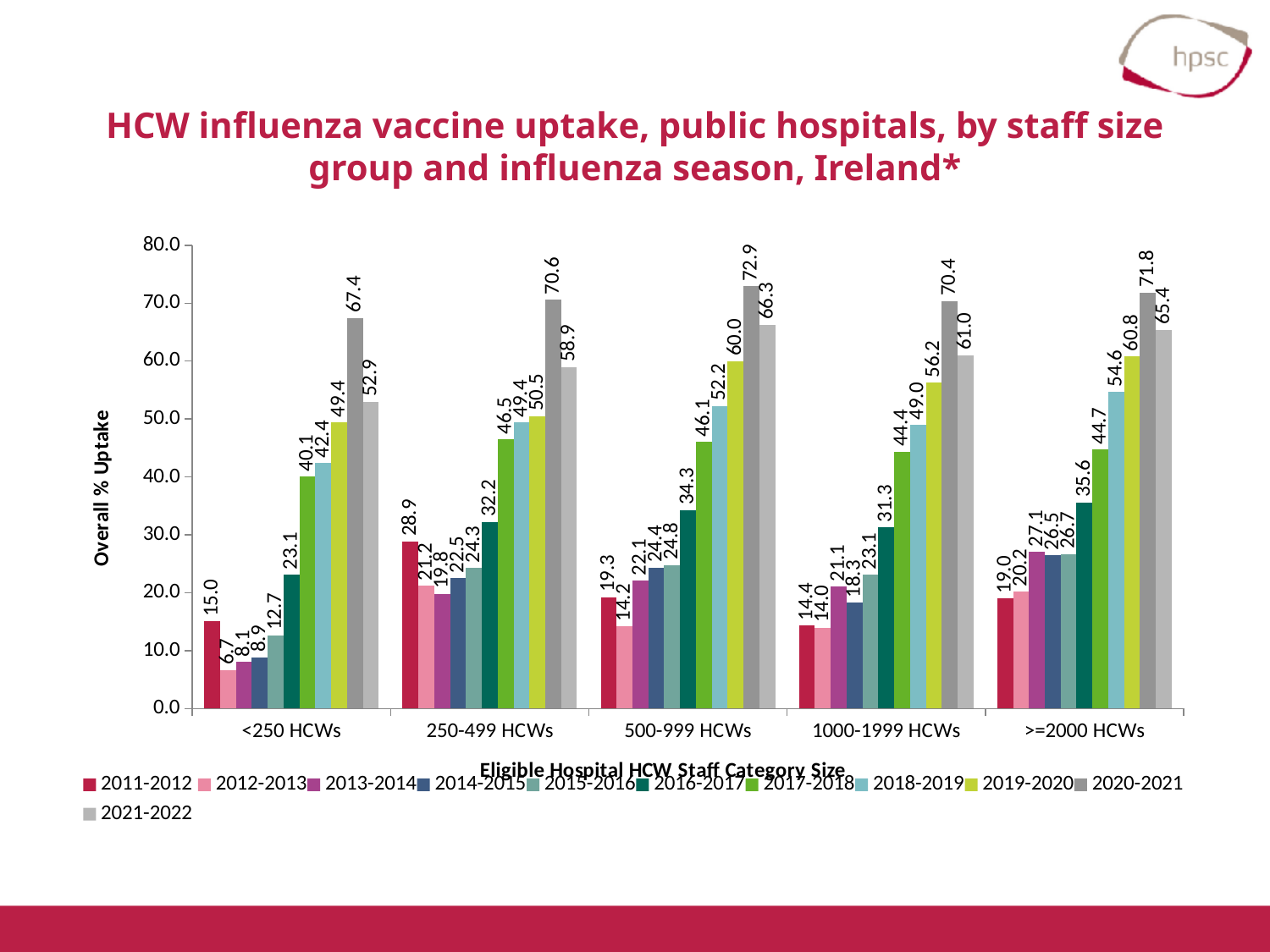
What is the difference between the 2021-2022 and 2011-2012 values for the >=2000 HCWs group? 46.4 What is the title of the y axis? Overall % Uptake How many staff size groups are shown on the x axis? 5 How many influenza seasons does the legend list? 11 Which season has the lowest value in the <250 HCWs group? 2012-2013 What is the 2011-2012 value for the 250-499 HCWs group? 28.9 What is the 2020-2021 value for the <250 HCWs group? 67.4 What kind of chart is shown on the slide? bar chart In the 500-999 HCWs group, do the values rise or fall from 2012-2013 through 2020-2021? rise Which staff size group has the highest 2020-2021 value? 500-999 HCWs Which is larger for 2019-2020: the 500-999 HCWs value or the >=2000 HCWs value? >=2000 HCWs Is the 2016-2017 value for the 250-499 HCWs group greater or less than 30.0? greater